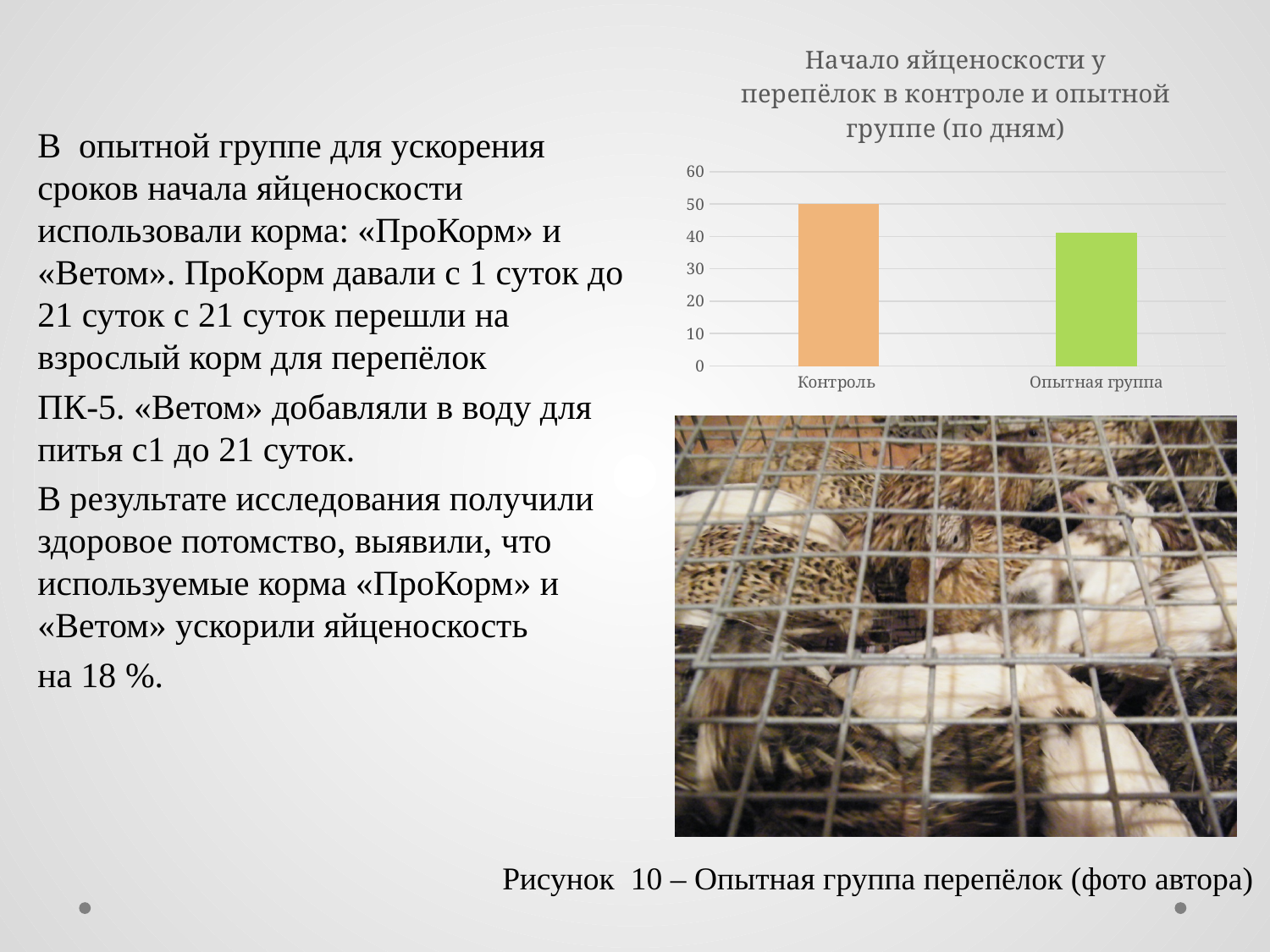
What kind of chart is shown on the slide? bar chart How many categories are shown on the x axis of the chart? 2 Which is larger, the value for Контроль or the value for Опытная группа? Контроль Which category has the lowest bar in the chart? Опытная группа Is the value for Опытная группа greater or less than 50? less Which category has the highest bar in the chart? Контроль What is the value for Контроль in the chart? 50 Do the values rise or fall from left to right along the x axis? fall Is the value for Контроль greater or less than 40? greater What is the title of the chart? Начало яйценоскости у перепёлок в контроле и опытной группе (по дням) What colour is the bar for Опытная группа? green